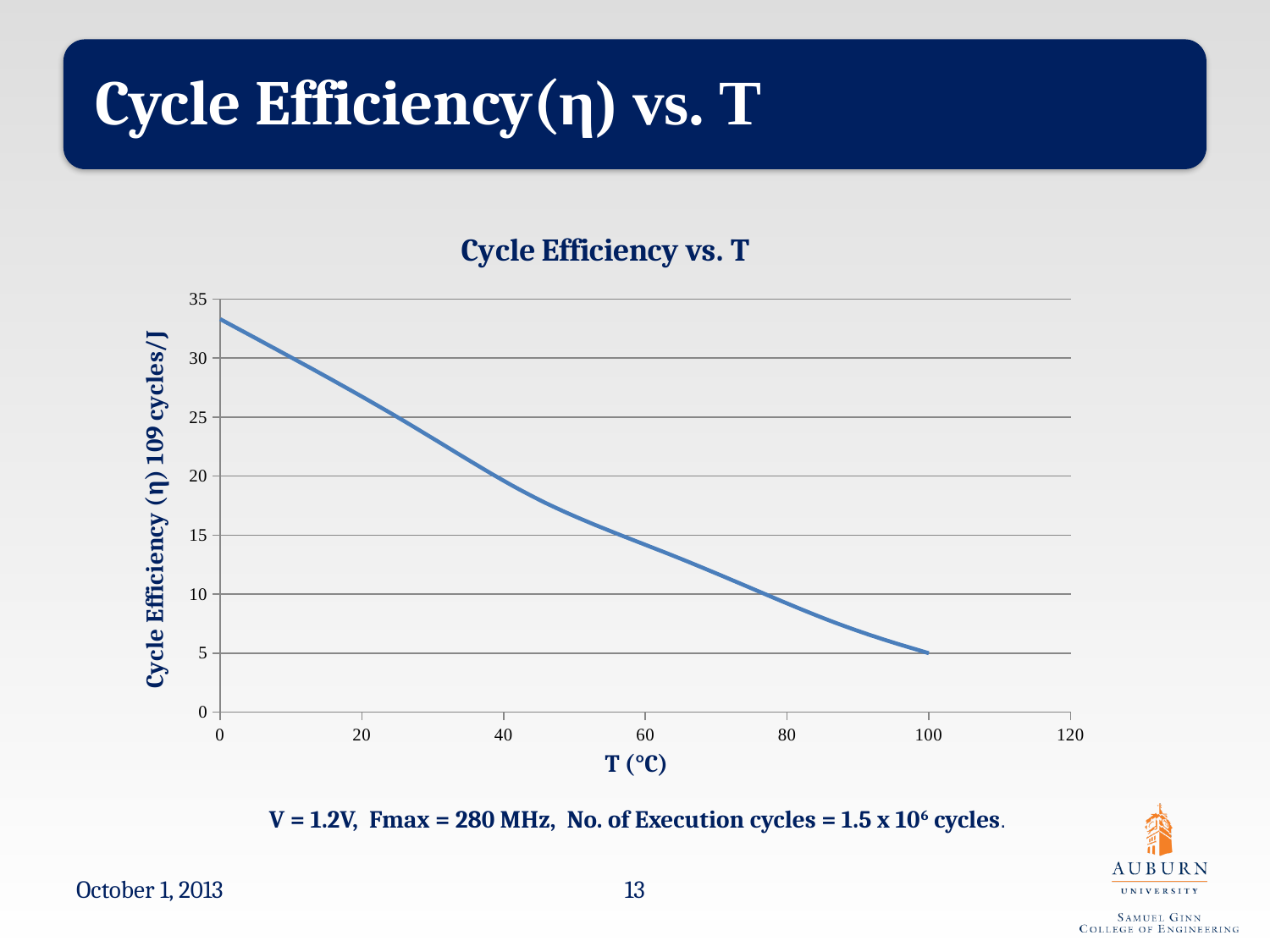
Is the cycle efficiency at T = 60 greater or less than 15? less At which temperature on the x axis is the cycle efficiency highest? 0 Is the cycle efficiency at T = 80 greater or less than 15? less Is the cycle efficiency at T = 20 greater or less than 25? greater What kind of chart is shown on the slide? line chart What is the label of the x axis? T (°C) Which has the higher cycle efficiency, T = 20 or T = 60? T = 20 What is the title of the chart? Cycle Efficiency vs. T Do the cycle efficiency values rise or fall as T increases along the x axis? fall What is the highest value shown on the y axis? 35